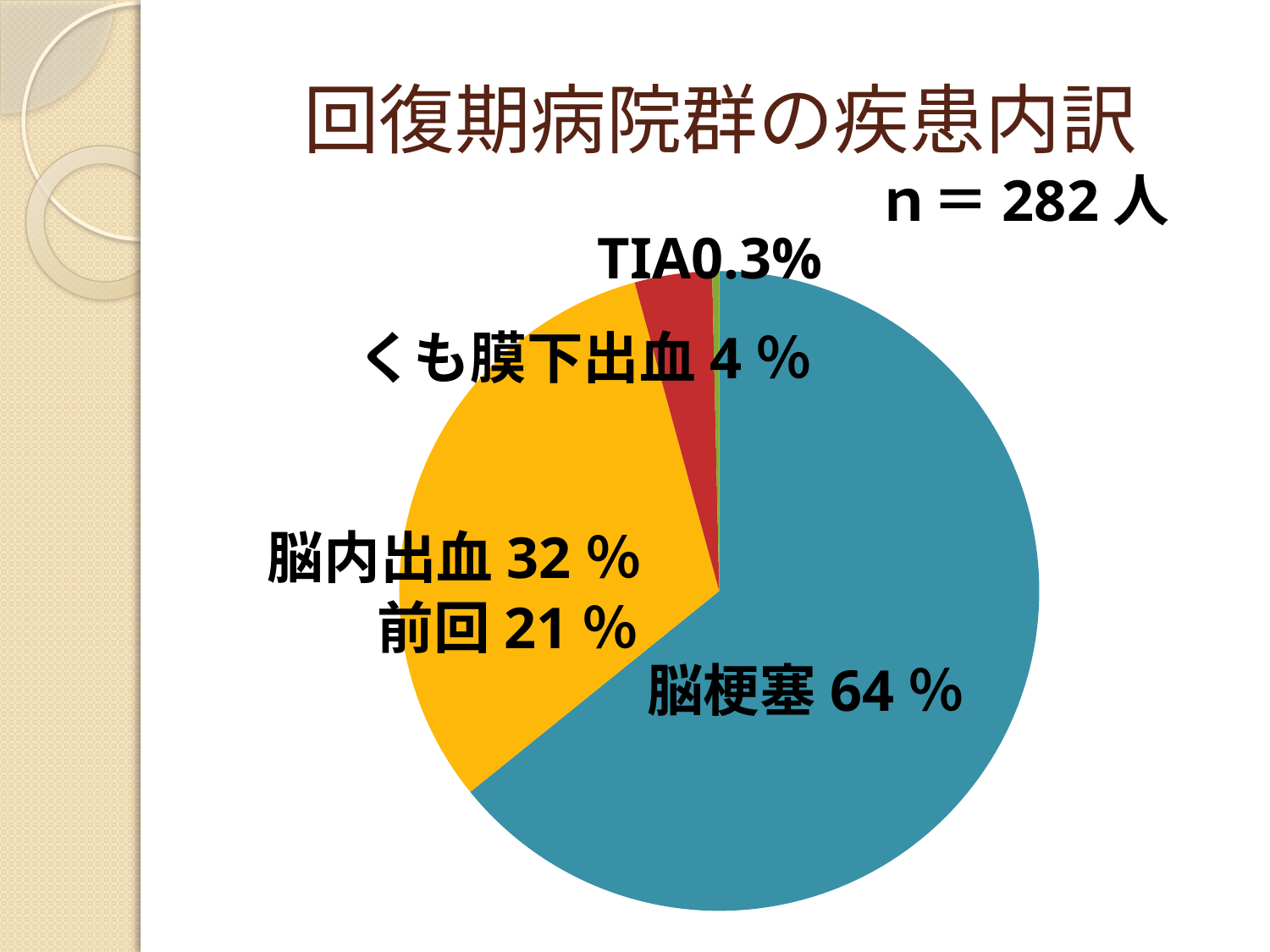
What percentage of the pie is TIA? 0.3% How many percentage points larger is 脳梗塞 than 脳内出血? 32 What kind of chart is shown on the slide? pie chart How many categories are shown in the pie chart? 4 What was the previous (前回) percentage shown for 脳内出血? 21 % Which category has the largest share of the pie? 脳梗塞 What is the title of the chart on the slide? 回復期病院群の疾患内訳 What is the sample size (n) shown on the slide? 282 人 What percentage of the pie is くも膜下出血? 4 % Which category has the smallest share of the pie? TIA What percentage of the pie is 脳梗塞? 64 % What percentage of the pie is 脳内出血? 32 %